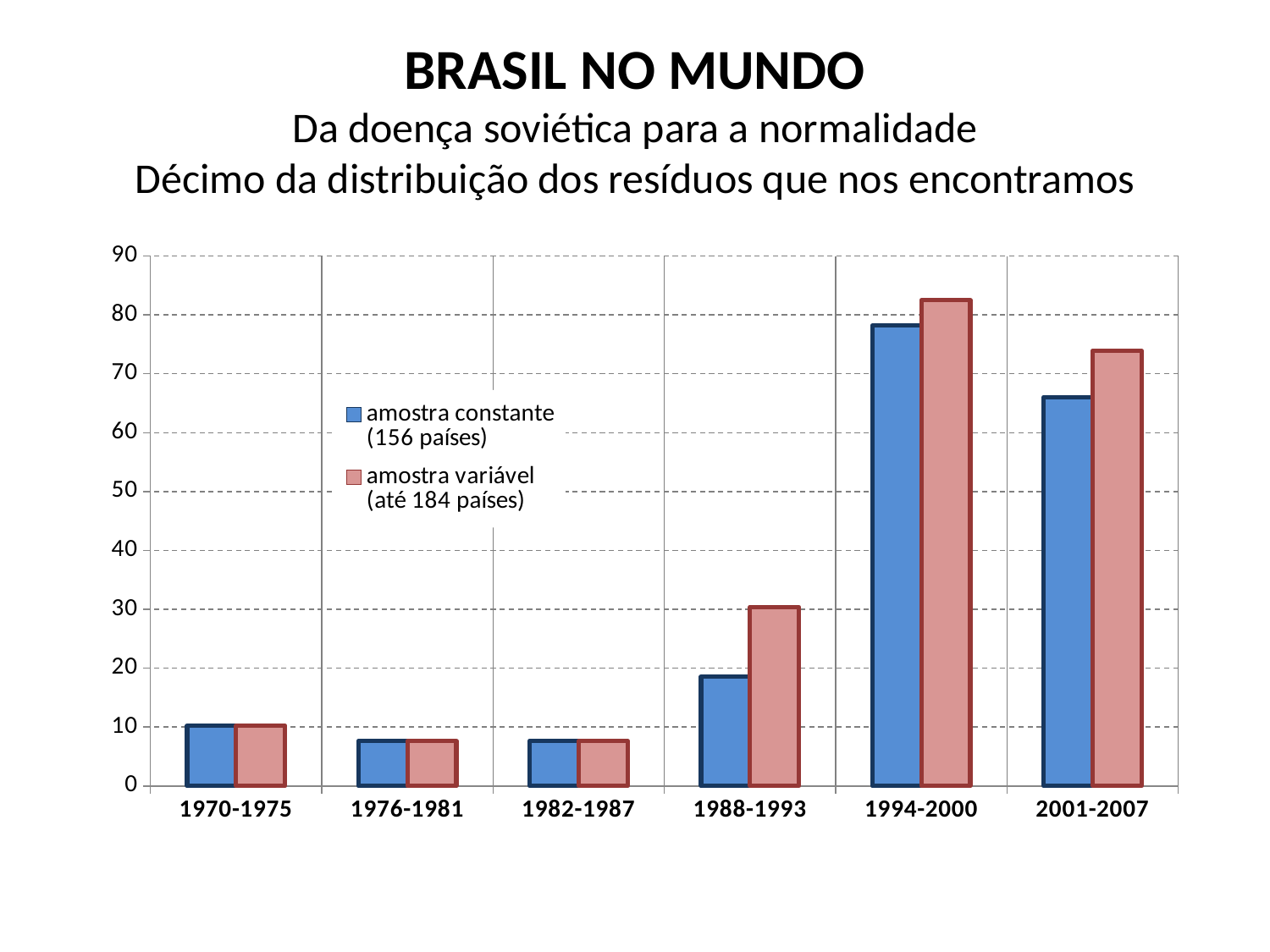
What kind of chart is shown on the slide? bar chart How many time periods are shown on the x axis of the chart? 6 Is the value for 'amostra constante (156 países)' in 2001-2007 greater or less than 60? greater Is the value for 'amostra variável (até 184 países)' in 1994-2000 greater or less than 80? greater Which colour represents 'amostra variável (até 184 países)' in the chart? red (pink) How many series does the chart's legend list? 2 In 2001-2007, which series has the larger value: 'amostra constante (156 países)' or 'amostra variável (até 184 países)'? amostra variável (até 184 países) In which period is the value for 'amostra constante (156 países)' highest? 1994-2000 In which period is the value for 'amostra variável (até 184 países)' highest? 1994-2000 Is the value for 'amostra constante (156 países)' in 1988-1993 greater or less than 20? less For 'amostra constante (156 países)', does the value rise or fall from 1994-2000 to 2001-2007? fall